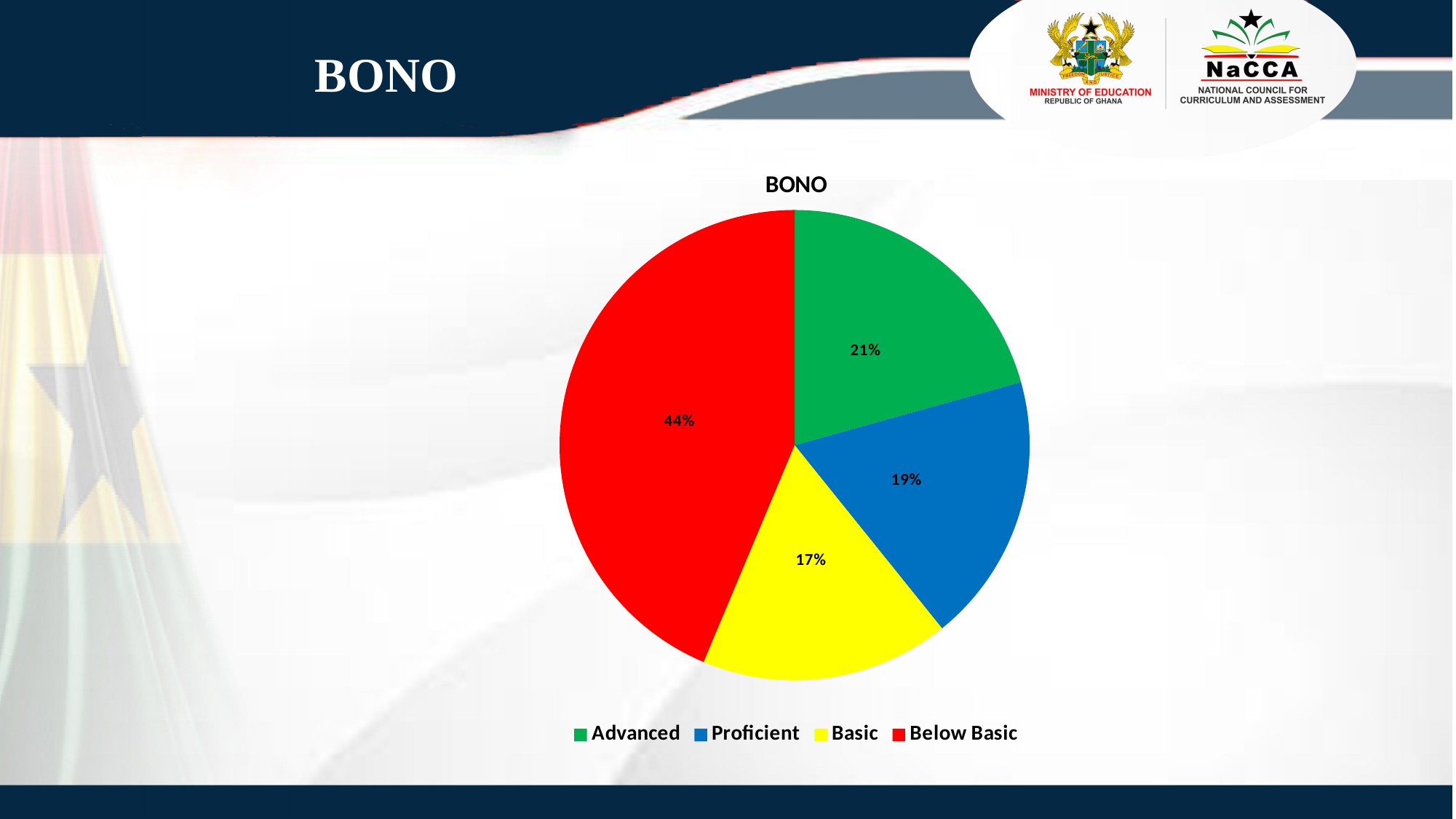
What percentage of the pie chart is labelled Proficient? 19% What percentage of the pie chart is labelled Below Basic? 44% What percentage of the pie chart is labelled Advanced? 21% What is the title of the chart? BONO What is the difference in percentage points between the Below Basic and Advanced slices? 23 Which slice is larger, Advanced or Proficient? Advanced What percentage of the pie chart is labelled Basic? 17% How many slices does the pie chart have? 4 Which colour represents the Basic category in the pie chart? Yellow Which category has the largest slice of the pie chart? Below Basic Which category has the smallest slice of the pie chart? Basic What kind of chart is shown on the slide? Pie chart